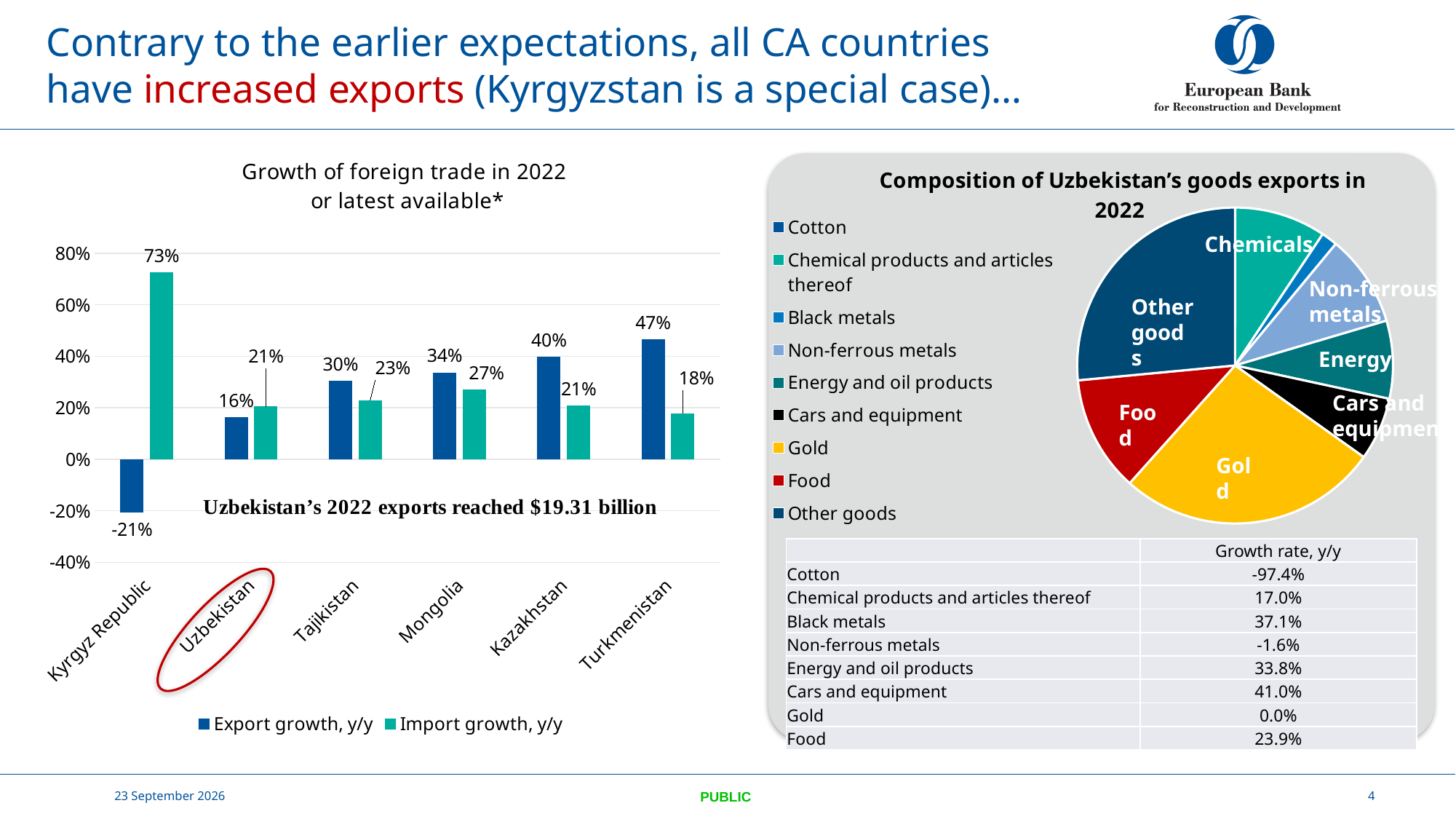
In the 'Growth of foreign trade in 2022 or latest available*' chart, which country has the lowest export growth? Kyrgyz Republic How many countries are shown in the 'Growth of foreign trade in 2022 or latest available*' chart? 6 How many series does the legend of the 'Growth of foreign trade in 2022 or latest available*' chart list? 2 In the 'Growth of foreign trade in 2022 or latest available*' chart, which country has the highest export growth? Turkmenistan In the 'Growth of foreign trade in 2022 or latest available*' chart, what is the difference between Kazakhstan's export growth and its import growth? 19 percentage points In the 'Growth of foreign trade in 2022 or latest available*' chart, which country has the highest import growth? Kyrgyz Republic In the 'Growth of foreign trade in 2022 or latest available*' chart, is Tajikistan's export growth or import growth larger? Export growth In the 'Growth of foreign trade in 2022 or latest available*' chart, what is the import growth for the Kyrgyz Republic? 73% In the 'Growth of foreign trade in 2022 or latest available*' chart, what is the export growth for Uzbekistan? 16% In the 'Growth of foreign trade in 2022 or latest available*' chart, what is the export growth for Turkmenistan? 47% What kind of chart is the 'Growth of foreign trade in 2022 or latest available*' chart? Bar chart What kind of chart is the 'Composition of Uzbekistan's goods exports in 2022' chart? Pie chart